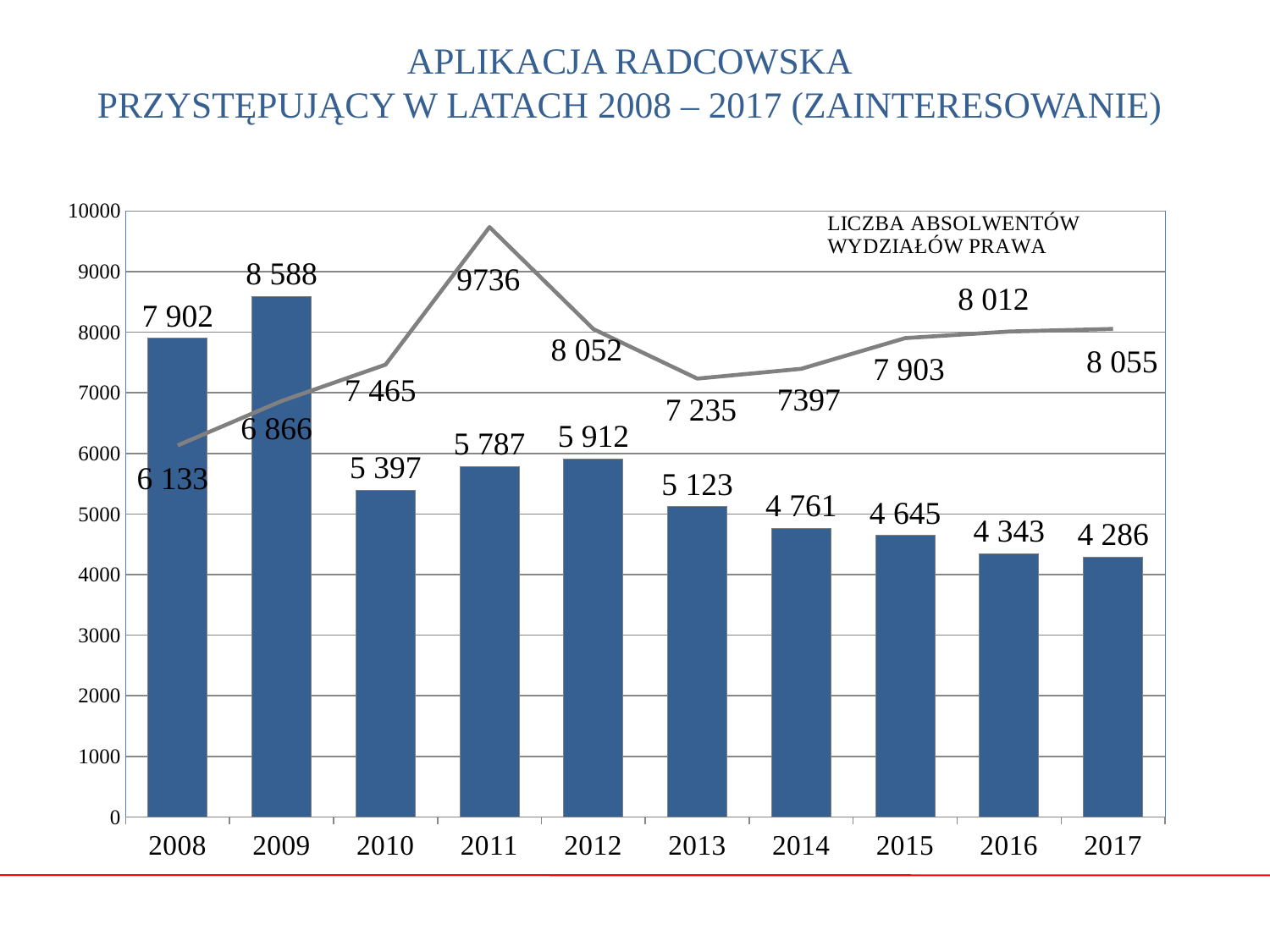
What is the difference between the bar values for 2009 and 2010? 3 191 Which is larger: the bar value for 2012 or the bar value for 2013? 2012 What is the label shown for the line series in the chart? LICZBA ABSOLWENTÓW WYDZIAŁÓW PRAWA Which year has the highest bar? 2009 Do the bar values rise or fall from 2012 to 2017? fall Which year has the lowest bar? 2017 What is the value of the line (LICZBA ABSOLWENTÓW WYDZIAŁÓW PRAWA) for 2008? 6 133 What is the value of the bar for 2009? 8 588 In which year does the line (LICZBA ABSOLWENTÓW WYDZIAŁÓW PRAWA) reach its highest value? 2011 How many years are shown on the x axis? 10 What is the value of the line (LICZBA ABSOLWENTÓW WYDZIAŁÓW PRAWA) for 2011? 9736 What is the value of the bar for 2017? 4 286